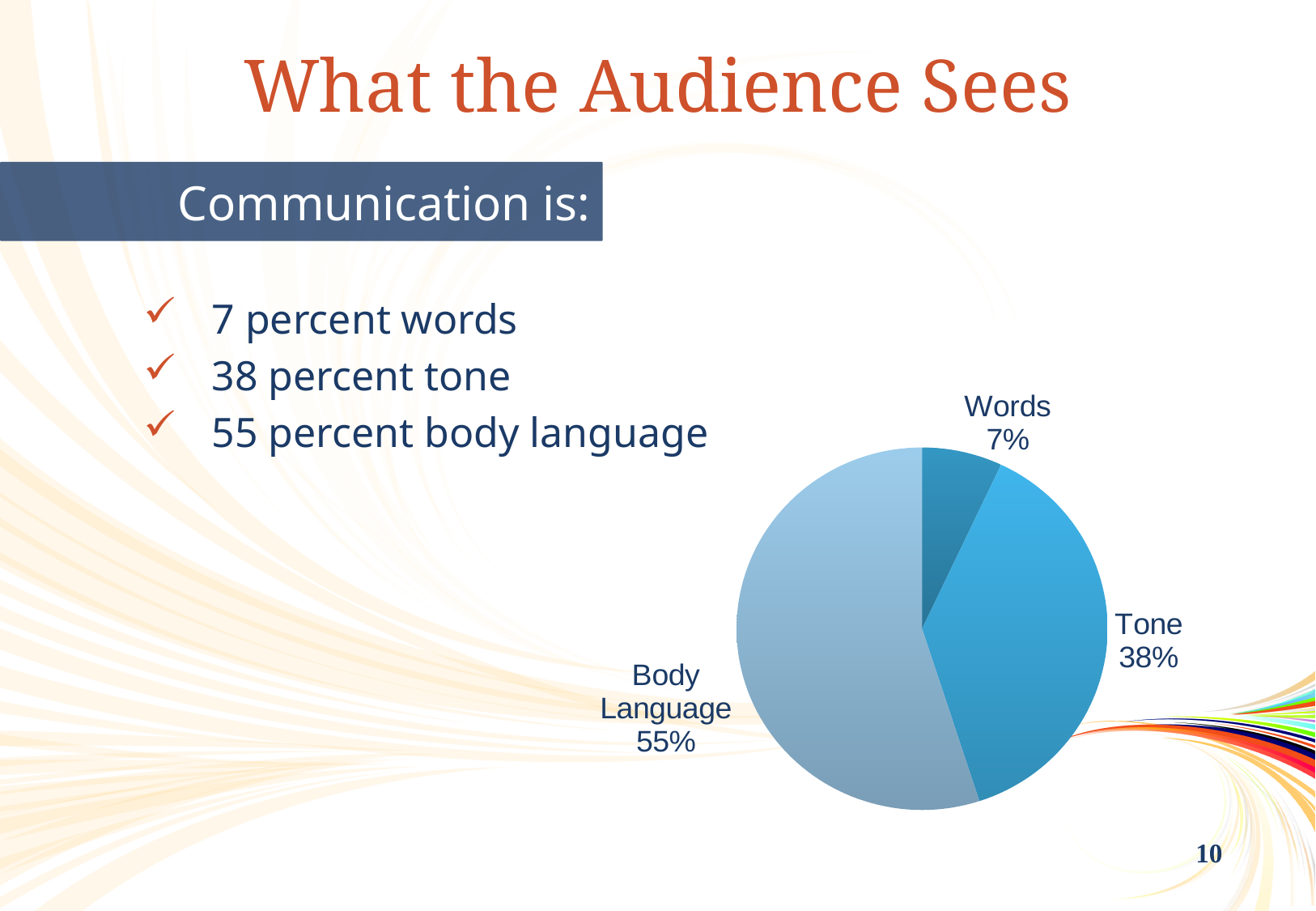
What is the difference in percentage points between Body Language and Tone in the pie chart? 17 What percentage of the pie chart is Words? 7% Which is larger in the pie chart, Tone or Words? Tone What percentage of the pie chart is Body Language? 55% What kind of chart is shown on the slide? pie chart What percentage of the pie chart is Tone? 38% Which slice of the pie chart is the smallest? Words What is the title of the slide containing the pie chart? What the Audience Sees What share of the pie does the Tone slice represent? 38% How many slices does the pie chart have? 3 Which slice of the pie chart is the largest? Body Language What is the difference in percentage points between Tone and Words in the pie chart? 31